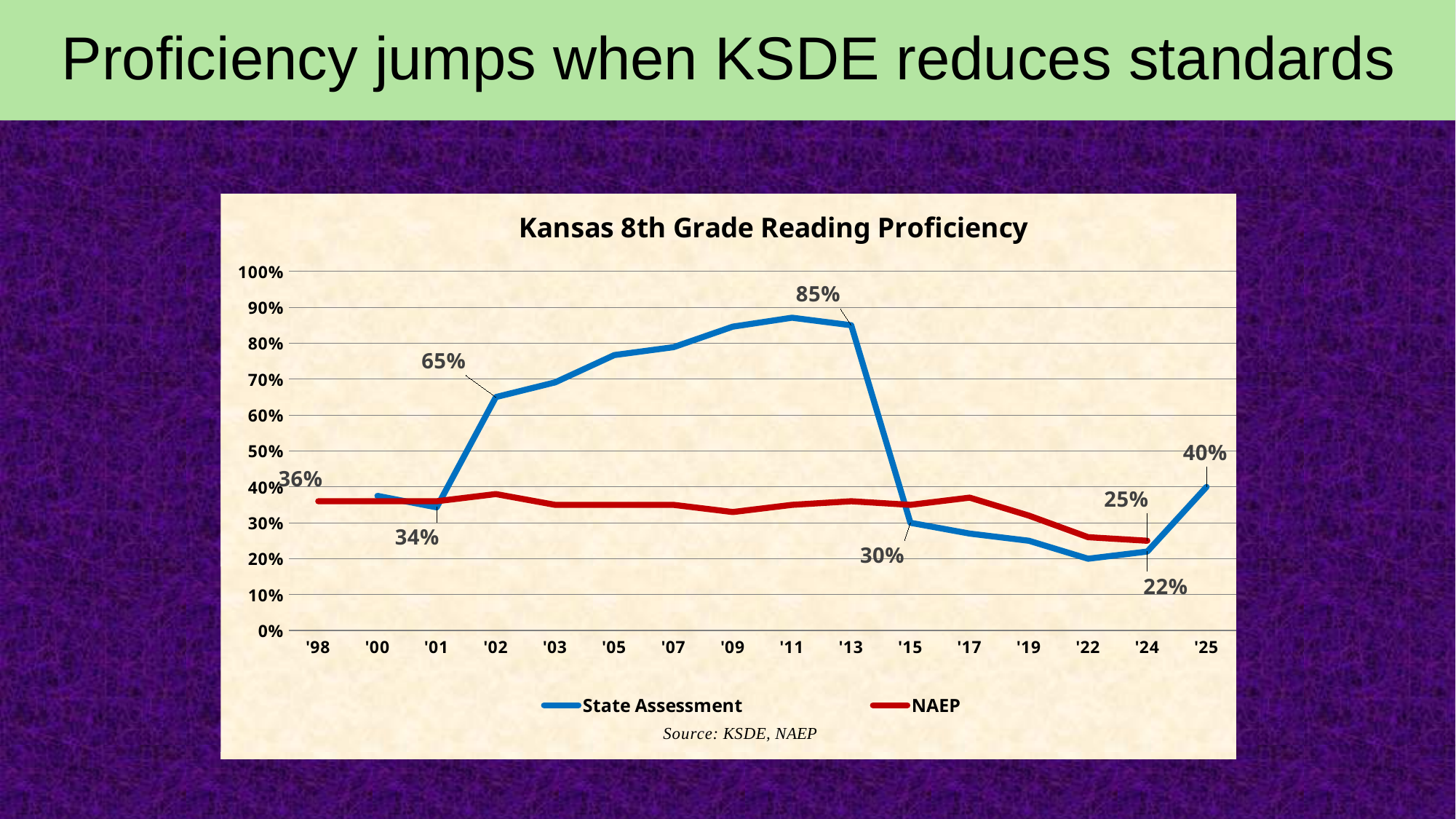
By how many percentage points did the State Assessment value drop from '13 to '15? 55 percentage points In '24, which series shows the higher value, State Assessment or NAEP? NAEP What is the State Assessment value for '02? 65% How many series does the legend list? 2 What is the State Assessment value for '13? 85% What is the State Assessment value for '25? 40% What is the title of the chart? Kansas 8th Grade Reading Proficiency Does the State Assessment line rise or fall from '13 to '22? fall What kind of chart is shown on the slide? line chart How many years are shown on the x axis? 16 What is the NAEP value for '24? 25% Is the State Assessment value for '11 greater or less than 80%? greater